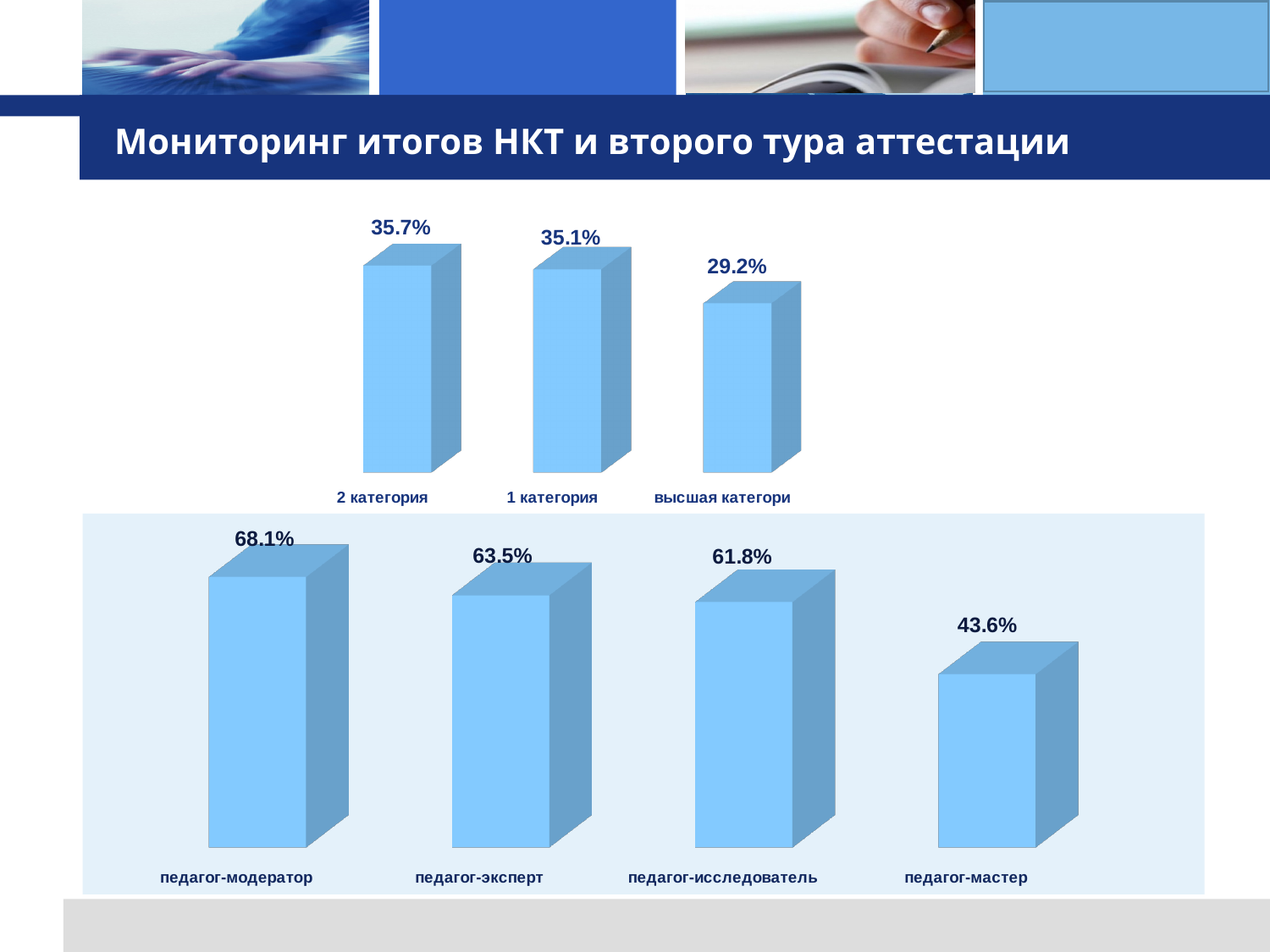
In the bottom chart, what is the value for педагог-эксперт? 63.5% How many categories are shown in the top chart? 3 In the top chart, what is the value for 2 категория? 35.7% In the bottom chart, which is larger: the value for педагог-эксперт or педагог-исследователь? педагог-эксперт In the bottom chart, what is the value for педагог-мастер? 43.6% In the bottom chart, which category has the lowest value? педагог-мастер In the top chart, which category has the lowest value? высшая категори In the top chart, what is the value for высшая категори? 29.2% In the top chart, what is the difference between the values for 2 категория and высшая категори? 6.5% In the bottom chart, which category has the highest value? педагог-модератор In the bottom chart, what is the difference between the values for педагог-модератор and педагог-мастер? 24.5% What type of chart is the bottom chart? bar chart